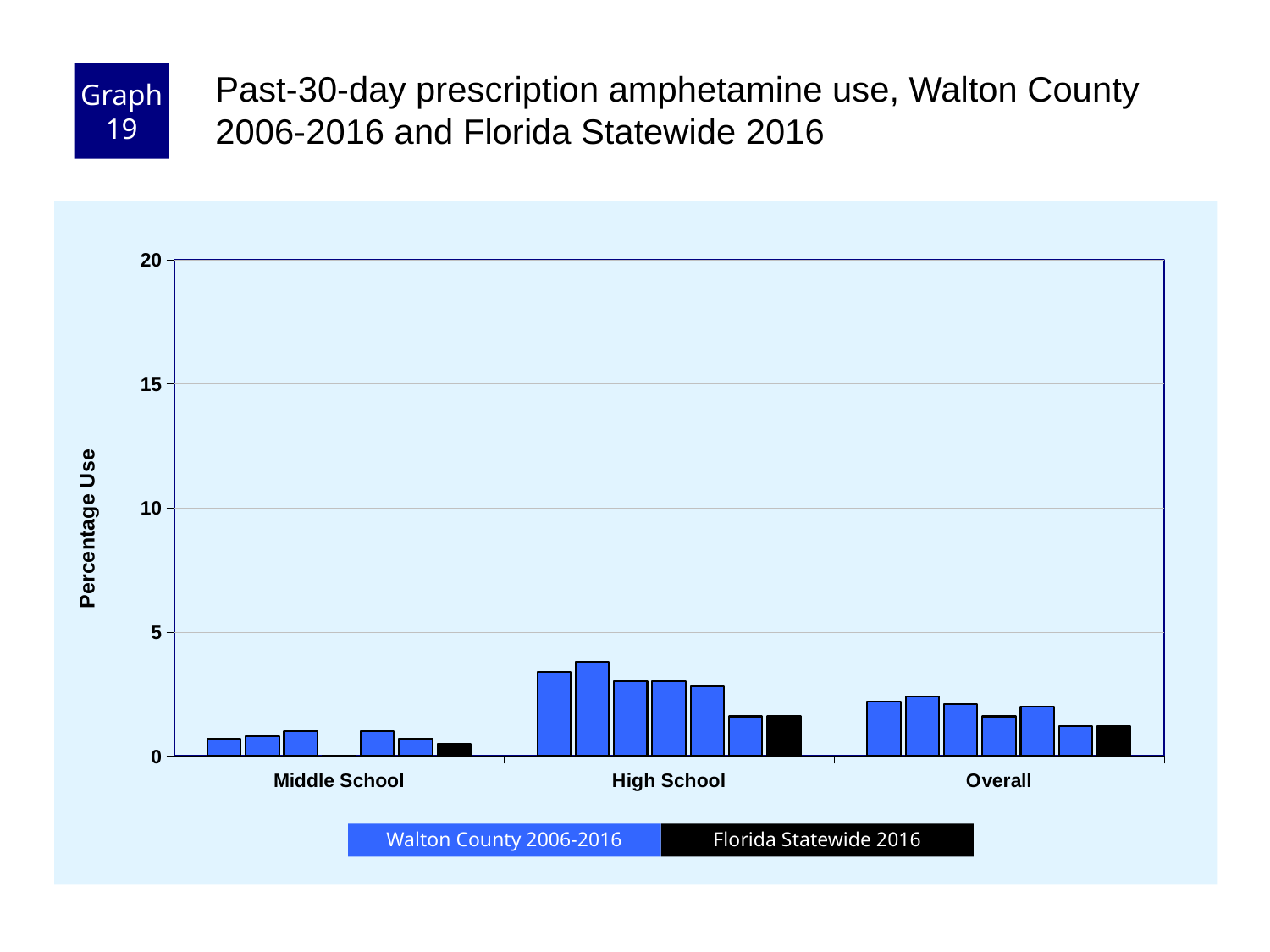
Which category group has the tallest bars in the chart? High School Which is larger: the Florida Statewide 2016 bar for Overall or the Florida Statewide 2016 bar for Middle School? Overall How many series does the chart's legend list? 2 What kind of chart is shown on the slide? bar chart What is the label on the y axis of the chart? Percentage Use Is the Florida Statewide 2016 value for Overall greater or less than 5? less Is the tallest Walton County bar for High School greater or less than 5? less How many categories are shown on the x axis of the chart? 3 Is the Florida Statewide 2016 value for High School greater or less than 5? less Which is larger: the Florida Statewide 2016 bar for High School or the Florida Statewide 2016 bar for Middle School? High School What colour are the Florida Statewide 2016 bars in the chart? black Which category group has the shortest bars in the chart? Middle School